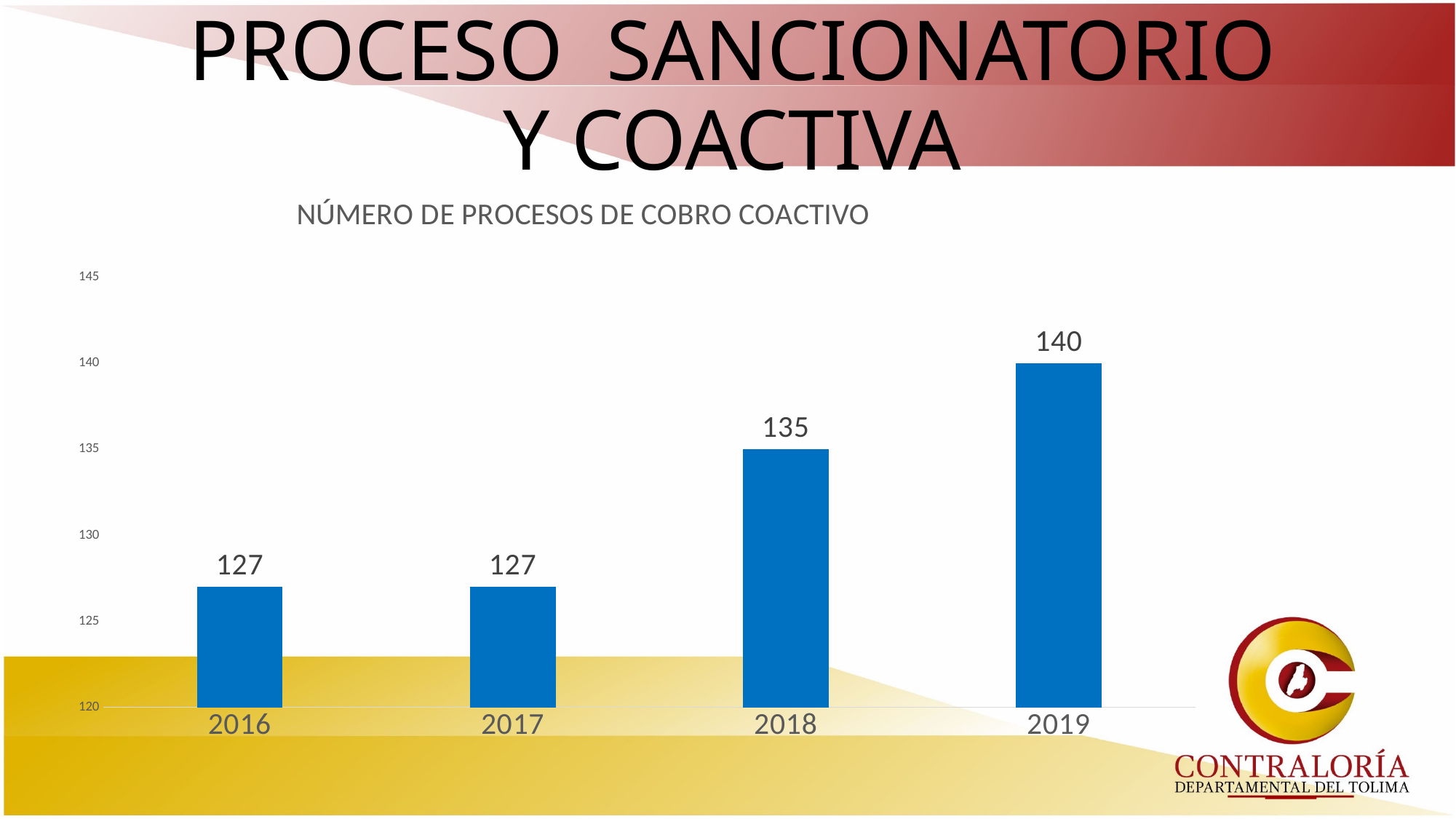
What kind of chart is shown on the slide? bar chart Is the value for 2018 greater or less than 130? greater Which year has the highest number of processes? 2019 How many years are shown on the x axis? 4 What is the title of the chart? NÚMERO DE PROCESOS DE COBRO COACTIVO What is the number of processes for 2019? 140 What is the difference between the values for 2019 and 2018? 5 Which is larger, the value for 2018 or the value for 2017? 2018 What is the difference between the values for 2018 and 2017? 8 What is the number of processes for 2018? 135 Do the values rise or fall from 2016 to 2019? rise What is the number of processes for 2016? 127